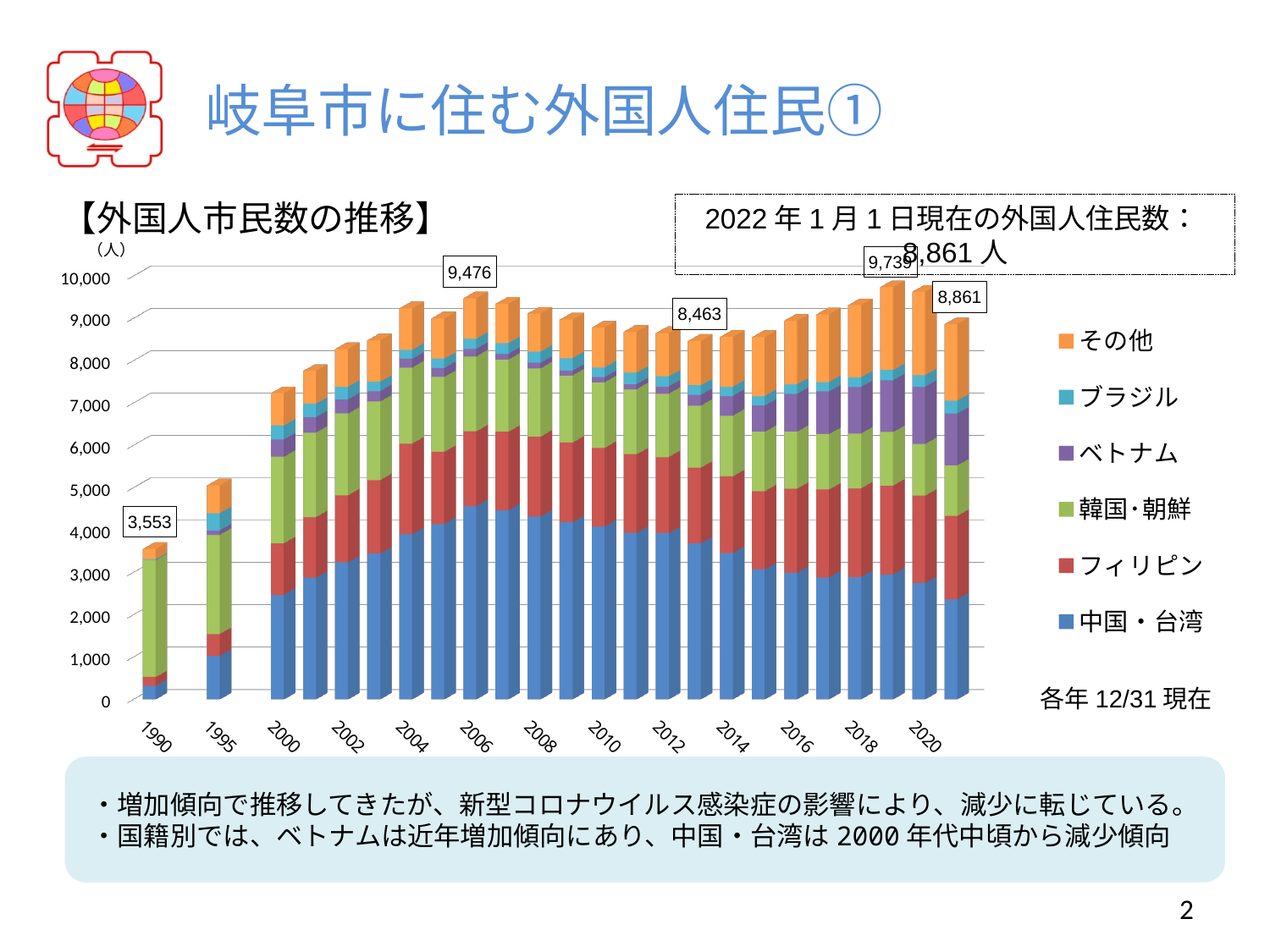
What kind of chart is shown on the slide? stacked bar chart What is the total number of foreign residents shown for 1990? 3,553 Which series is plotted at the bottom of each stacked bar? 中国・台湾 What is the total number of foreign residents shown for 2006? 9,476 Is the total for 1995 greater or less than 6,000? less What is the total number of foreign residents shown for the last bar (2021)? 8,861 How many series does the legend list? 6 Which year has the larger total, 2006 or 2012? 2006 Which year has the lowest total bar? 1990 By how much does the 2021 total (8,861) exceed the 1990 total (3,553)? 5,308